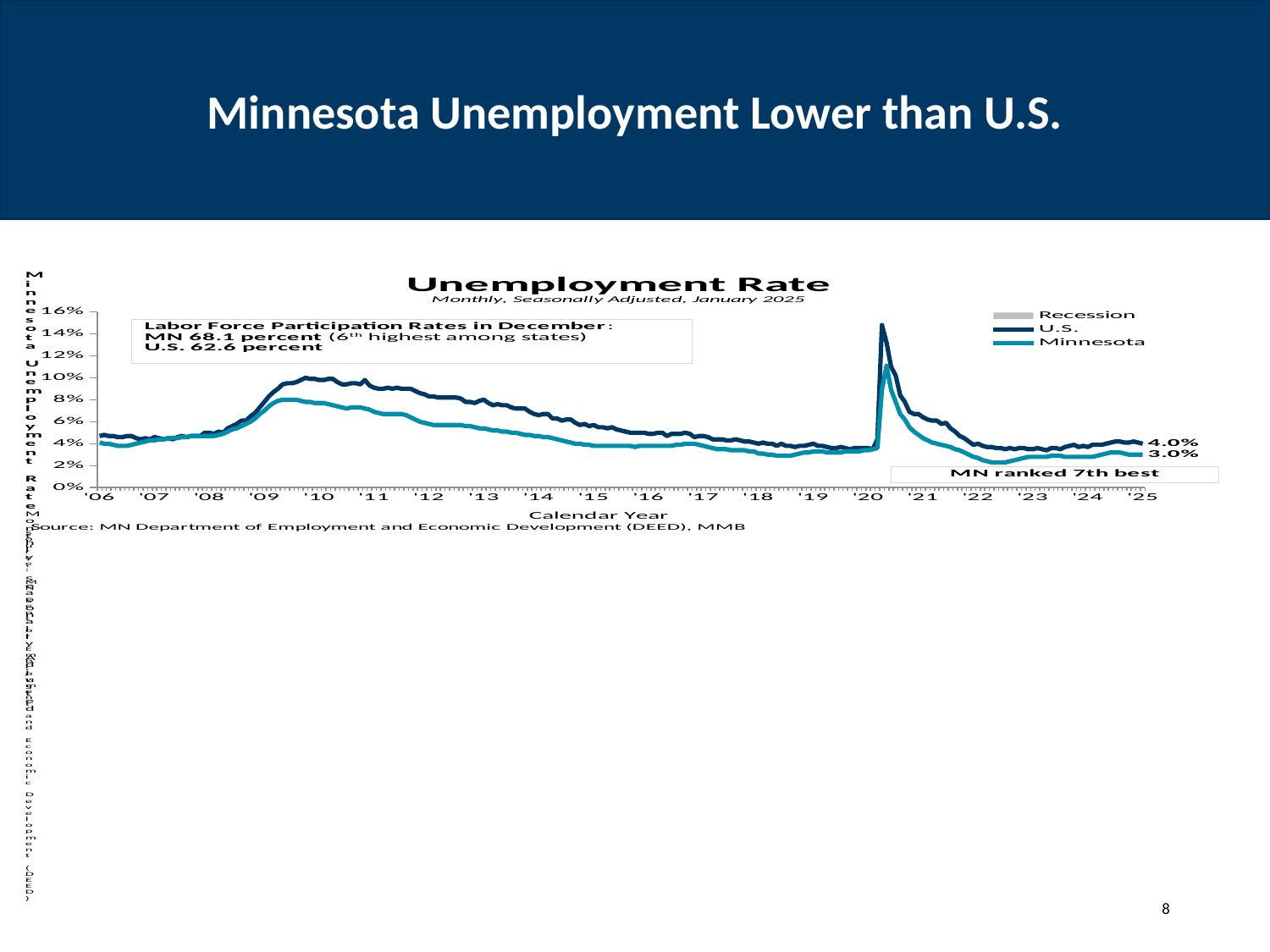
Is the peak Minnesota unemployment rate in 2020 greater or less than 8%? greater What is the latest value shown for the U.S. unemployment rate at the right end of the chart? 4.0% How many entries does the chart legend list? 3 How many year labels are shown on the x axis? 20 What kind of chart is used to show the unemployment rates? Line chart What is the label on the x axis of the chart? Calendar Year What is the latest value shown for the Minnesota unemployment rate at the right end of the chart? 3.0% Is the Minnesota unemployment rate around '18 greater or less than 4%? less Is the peak U.S. unemployment rate in 2020 greater or less than 12%? greater Between '10 and '19, does the U.S. unemployment rate generally rise or fall? Fall By how much does the labeled U.S. unemployment rate exceed the labeled Minnesota rate at the end of the chart? 1.0% At the right end of the chart, which series has the higher unemployment rate, U.S. or Minnesota? U.S.